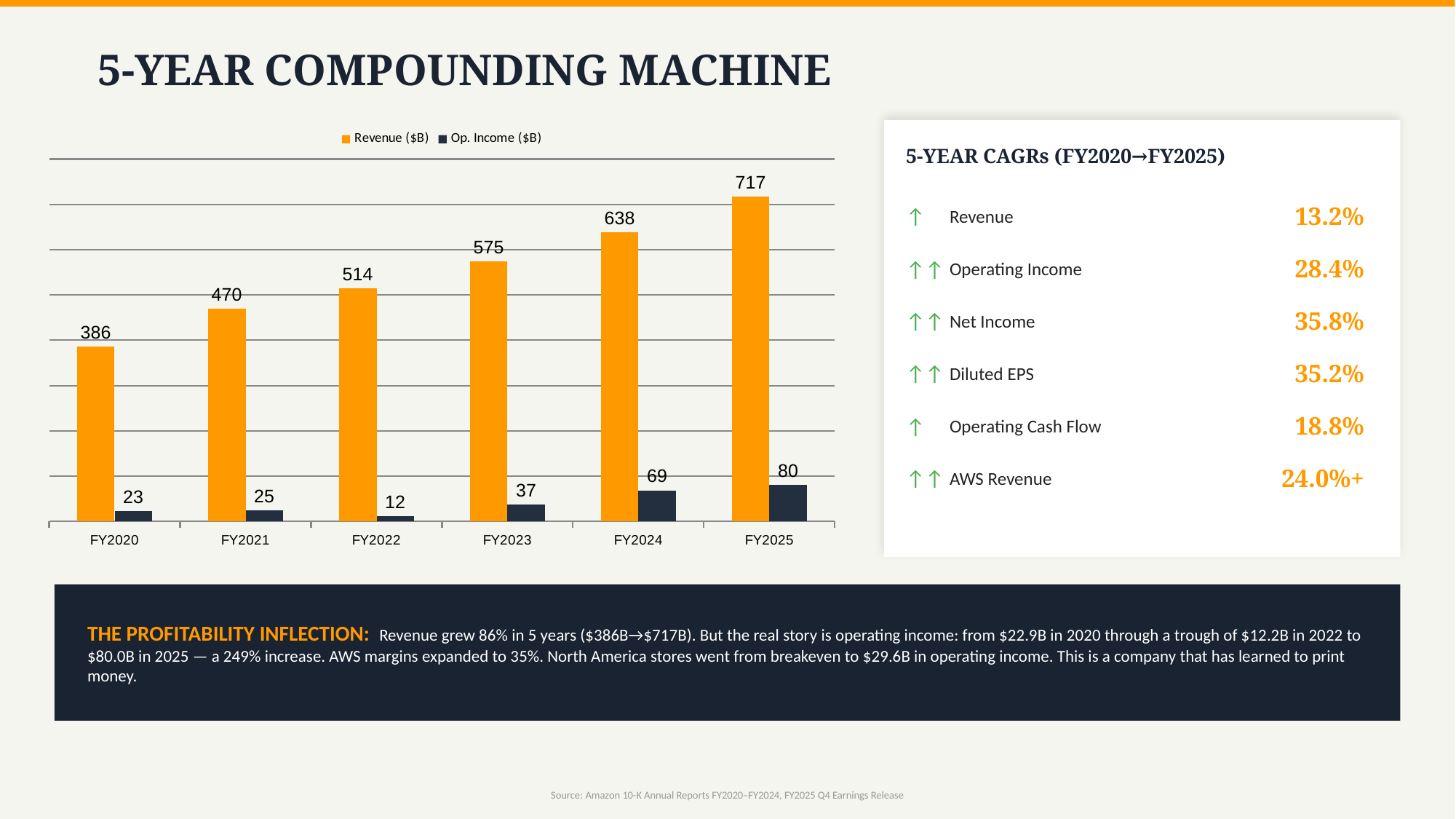
Which colour represents Revenue ($B) in the chart? Orange How many fiscal years are shown on the x axis of the chart? 6 What is the difference between Op. Income ($B) in FY2024 and FY2023? 32 Does Revenue ($B) rise or fall from FY2020 to FY2025? Rise What kind of chart is shown on the slide? Bar chart Which fiscal year has the lowest Op. Income ($B)? FY2022 What is the Revenue ($B) value for FY2022? 514 Which is larger: Op. Income ($B) in FY2021 or in FY2022? FY2021 What is the difference between Revenue ($B) in FY2025 and FY2020? 331 How many series does the chart legend list? 2 Which fiscal year has the highest Revenue ($B)? FY2025 What is the Op. Income ($B) value for FY2023? 37